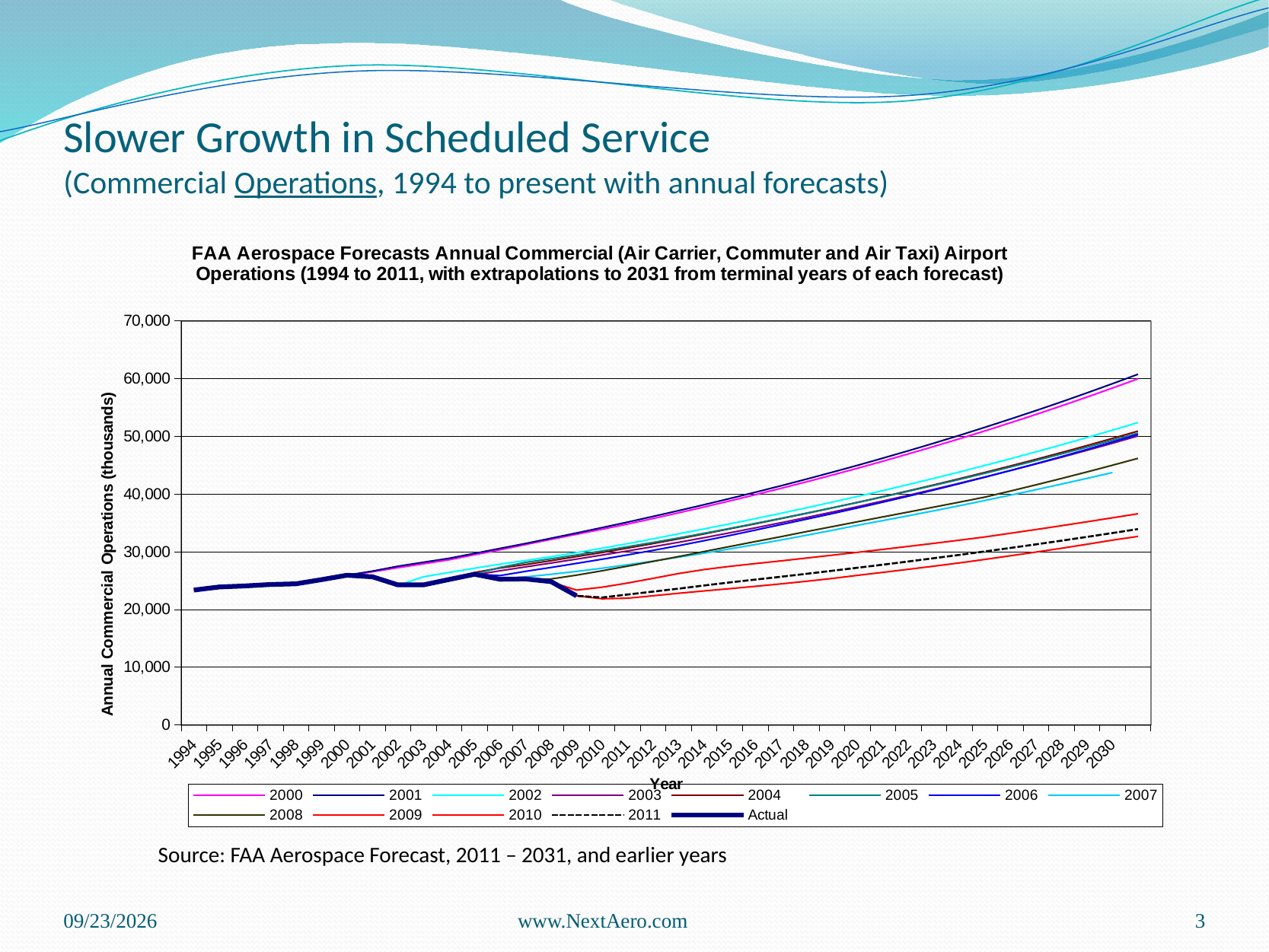
How many series does the chart legend list? 13 In 2030, which is larger: the 2000 forecast series or the 2011 forecast series? 2000 forecast series Which series in the legend is drawn with a dashed line? 2011 Is the Actual value for 2009 greater or less than 30,000? less Is the value of the 2000 forecast series in 2030 greater or less than 50,000? greater Is the value of the 2011 forecast series in 2030 greater or less than 40,000? less Does the Actual series rise or fall between 2005 and 2009? fall How many years are labelled along the x axis of the chart? 37 What is the label of the y axis of the chart? Annual Commercial Operations (thousands) What kind of chart is shown on the slide? line chart